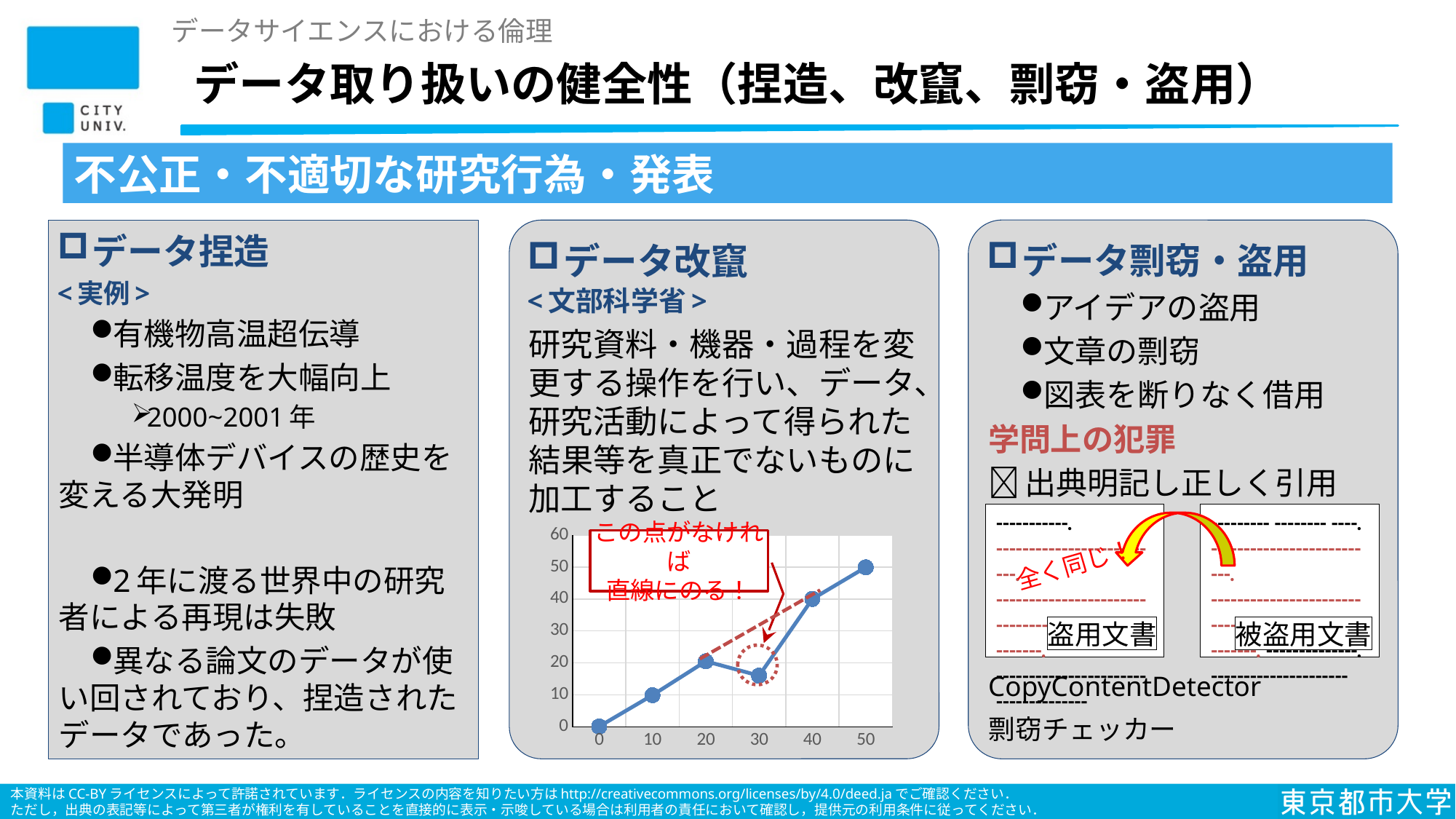
How many data points are plotted on the line chart? 6 Which point on the line chart is circled with a red dashed circle? the point at x = 30 Which is larger on the line chart, the value at x = 20 or the value at x = 30? x = 20 At which x value does the line chart have its lowest point? 0 At which x value does the line chart reach its highest point? 50 What kind of chart is shown in the データ改竄 panel? line chart Is the value of the line chart at x = 30 greater or less than 20? less What is the value of the line chart at x = 40? 40